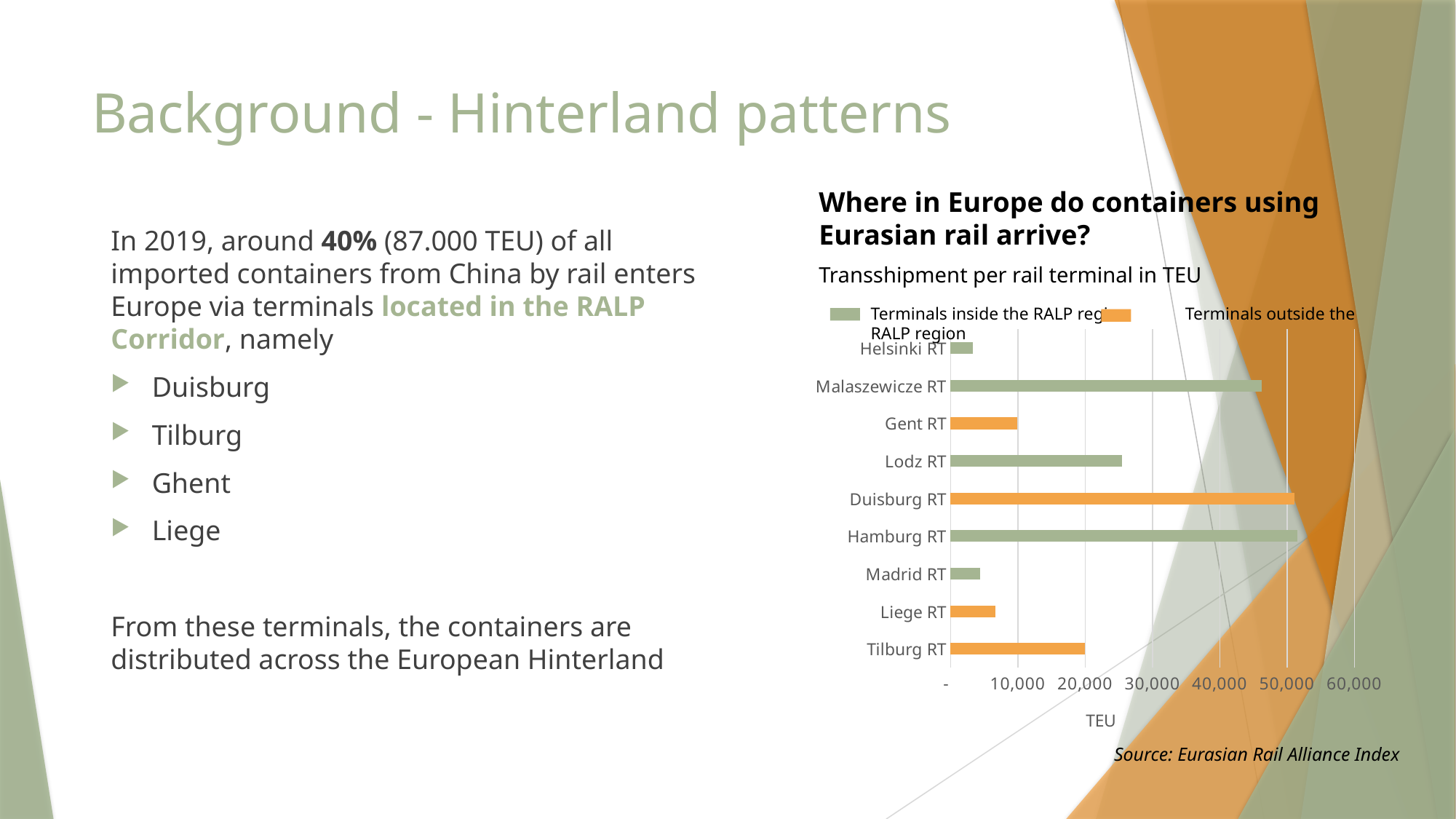
Is the value for Lodz RT greater or less than 20,000? greater Is the value for Tilburg RT greater or less than 30,000? less What is the label on the horizontal axis of the chart? TEU What is the subtitle of the chart describing what is plotted? Transshipment per rail terminal in TEU Is the value for Liege RT greater or less than 10,000? less How many series does the chart legend list? 2 Which has a higher value, Tilburg RT or Gent RT? Tilburg RT How many rail terminals are listed on the chart? 9 What kind of chart is shown on the slide? bar chart Which has a higher value, Malaszewicze RT or Lodz RT? Malaszewicze RT